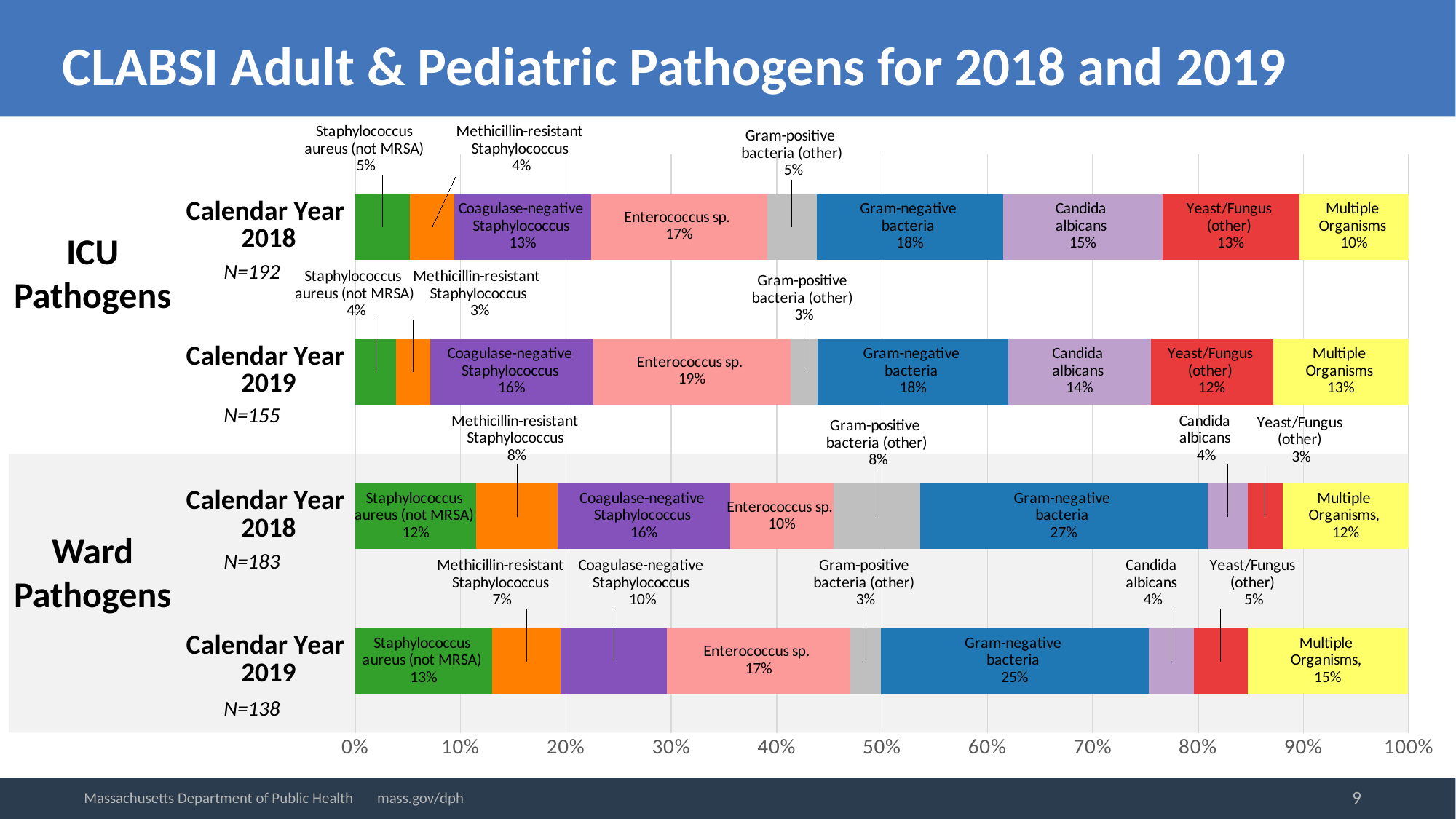
What percentage of ICU pathogens in Calendar Year 2019 were Coagulase-negative Staphylococcus? 16% What percentage of ICU pathogens in Calendar Year 2018 were Gram-negative bacteria? 18% How many bars (calendar year groups) are shown in the chart? 4 What kind of chart is shown on the slide? Stacked bar chart What percentage of Ward pathogens in Calendar Year 2018 were Multiple Organisms? 12% Which pathogen category had the largest share of Ward pathogens in Calendar Year 2018? Gram-negative bacteria What is the N value for Ward pathogens in Calendar Year 2019? N=138 Which pathogen category had the smallest share of ICU pathogens in Calendar Year 2019? Methicillin-resistant Staphylococcus and Gram-positive bacteria (other) (both 3%) What is the difference between the Multiple Organisms share for ICU pathogens in 2019 and in 2018? 3% What is the difference in the Gram-negative bacteria share between Ward pathogens in 2018 and Ward pathogens in 2019? 2% What percentage of Ward pathogens in Calendar Year 2019 were Enterococcus sp.? 17% Which is larger for ICU pathogens in Calendar Year 2018: the share of Enterococcus sp. or the share of Candida albicans? Enterococcus sp.